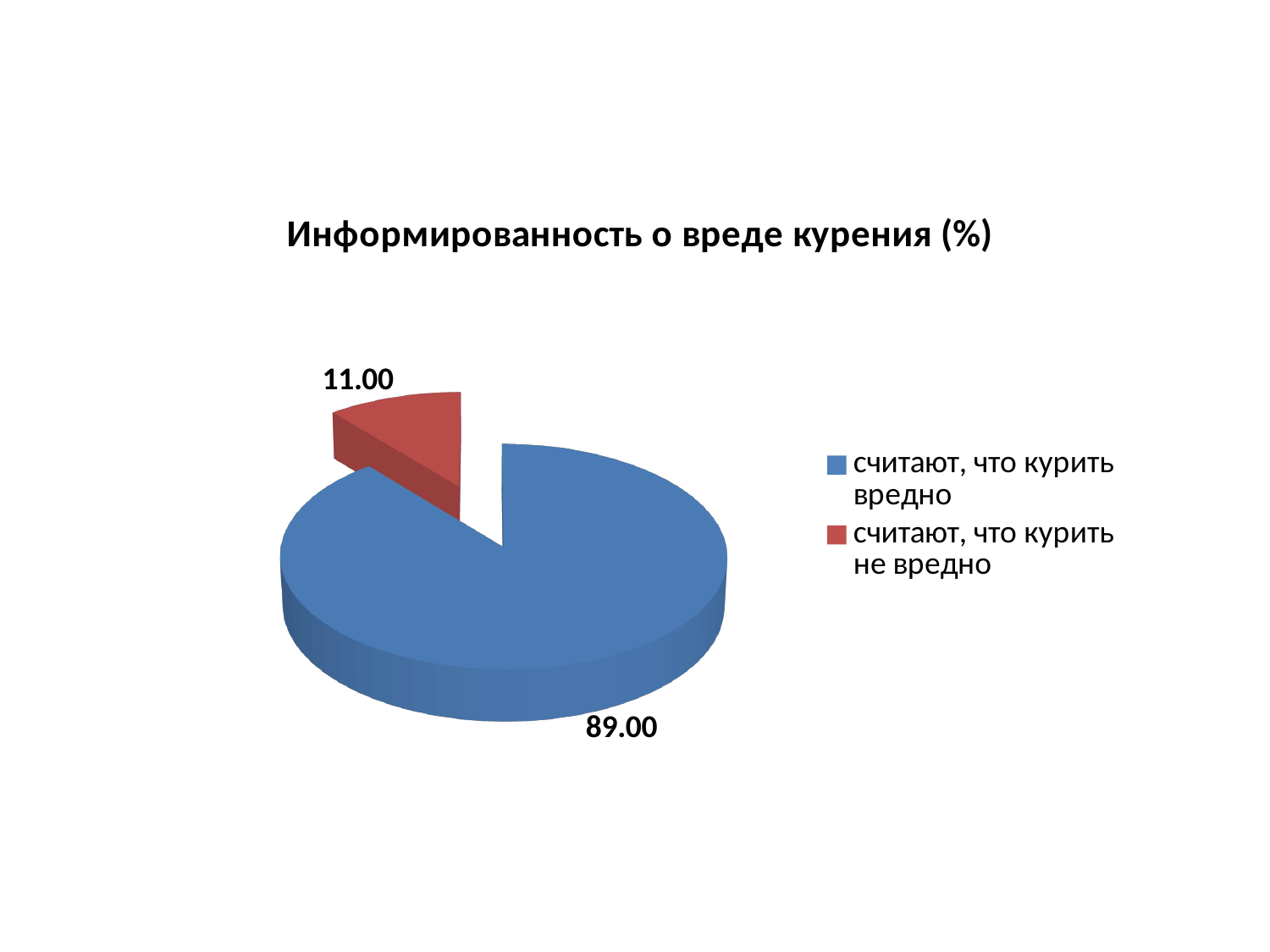
Which is larger: the slice for 'считают, что курить вредно' or the slice for 'считают, что курить не вредно'? считают, что курить вредно What is the title of the chart? Информированность о вреде курения (%) What is the value for the slice 'считают, что курить вредно'? 89.00 How many slices does the pie chart have? 2 What colour is the slice for 'считают, что курить не вредно'? red What is the total of the two slice values shown on the pie chart? 100.00 What kind of chart is shown on the slide? pie chart How many entries does the legend list? 2 Which category has the largest slice of the pie? считают, что курить вредно What is the value for the slice 'считают, что курить не вредно'? 11.00 Which category has the smallest slice of the pie? считают, что курить не вредно What is the difference between the values for 'считают, что курить вредно' and 'считают, что курить не вредно'? 78.00